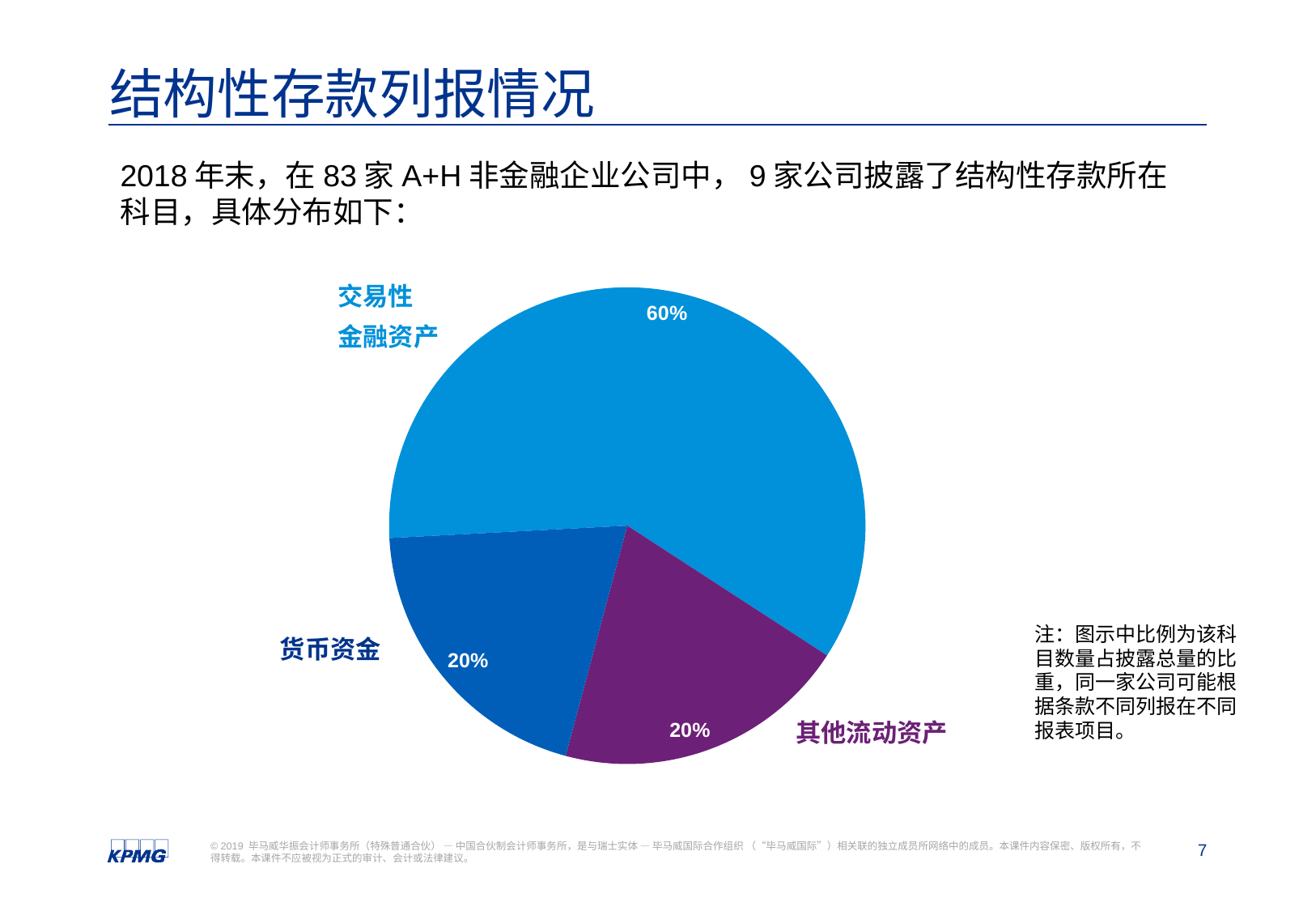
What share of the pie does 交易性金融资产 account for? 60% Which is larger, the slice for 交易性金融资产 or the slice for 货币资金? 交易性金融资产 What share of the pie does 货币资金 account for? 20% Is the share for 交易性金融资产 greater or less than 50%? greater Do the slices for 货币资金 and 其他流动资产 have the same share? Yes, both are 20% Which category has the largest slice of the pie? 交易性金融资产 How many slices does the pie chart have? 3 What colour is the 其他流动资产 slice? purple What share of the pie does 其他流动资产 account for? 20% What kind of chart is shown on the slide? pie chart What is the title of the slide containing the pie chart? 结构性存款列报情况 What is the difference in percentage points between the 交易性金融资产 slice and the 其他流动资产 slice? 40 percentage points